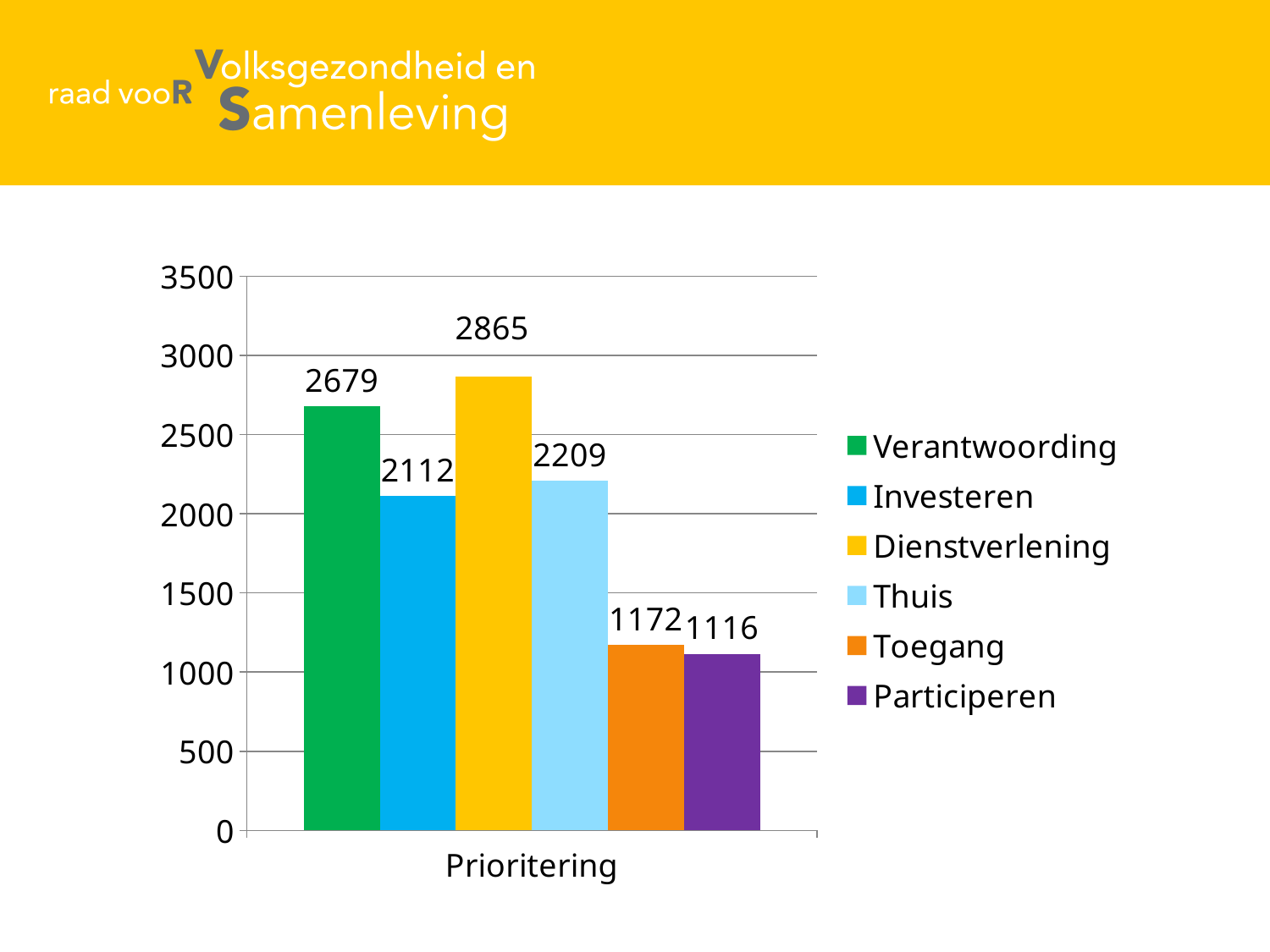
Which series has the highest value? Dienstverlening What is the value for Verantwoording? 2679 How many series does the legend list? 6 Which series has the lowest value? Participeren Is the value for Toegang greater or less than 1000? greater Which is larger, the value for Thuis or the value for Investeren? Thuis What is the label on the x axis of the chart? Prioritering What is the value for Participeren? 1116 What is the difference between the values for Dienstverlening and Verantwoording? 186 What kind of chart is shown on the slide? bar chart What is the difference between the values for Thuis and Investeren? 97 What is the value for Dienstverlening? 2865